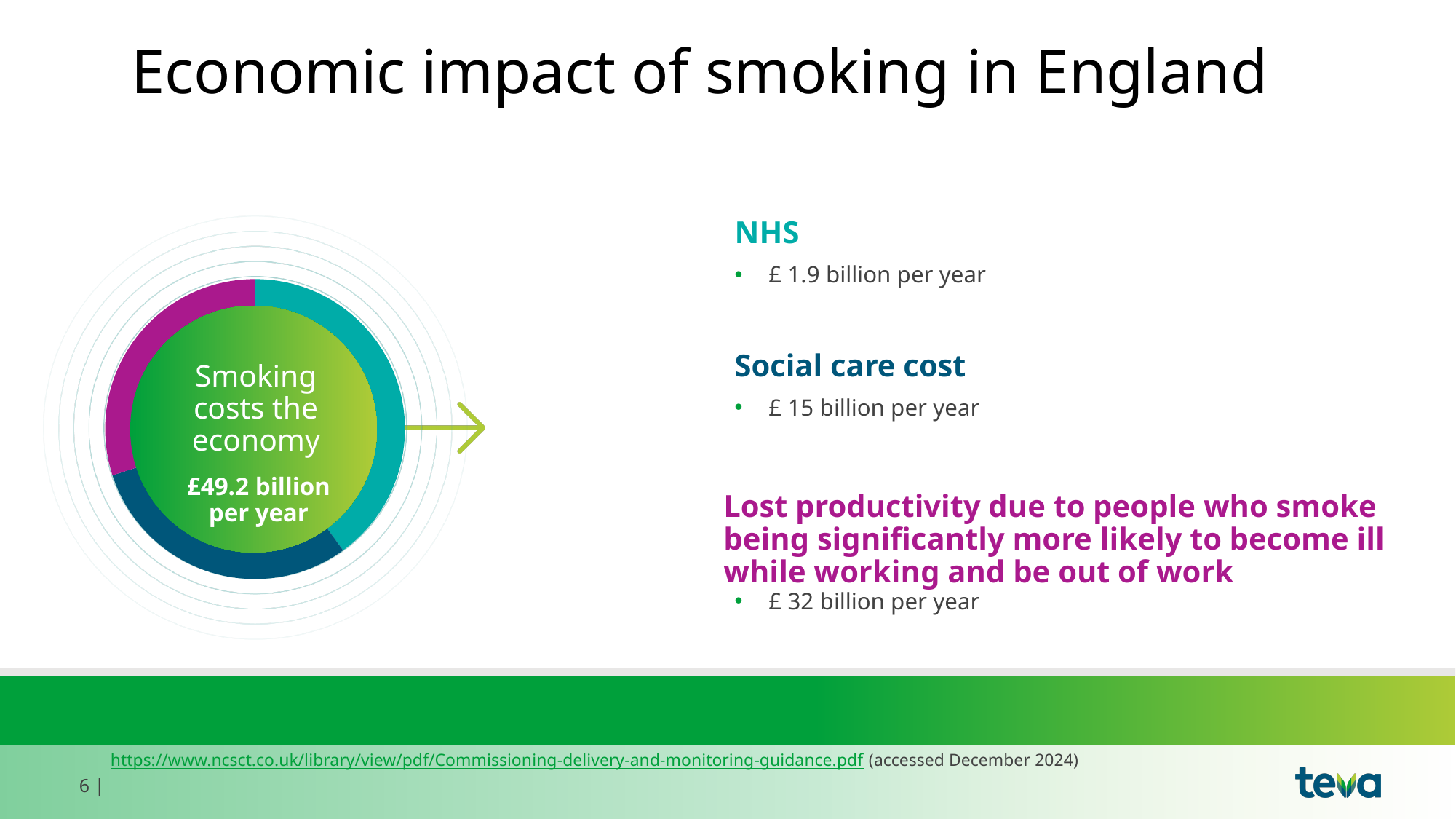
How many segments does the donut chart have? 3 How much larger is the lost productivity cost than the social care cost? £17 billion per year Which cost category has the lowest value? NHS What is the cost of lost productivity due to smoking per year? £ 32 billion per year Which cost category has the highest value? Lost productivity What is the NHS cost of smoking per year? £ 1.9 billion per year According to the slide, what is the total cost of smoking to the economy per year? £49.2 billion per year What kind of chart is shown on the slide? pie (donut) chart What is the social care cost of smoking per year? £ 15 billion per year What is the title of the slide? Economic impact of smoking in England Which is larger, the social care cost or the NHS cost? Social care cost What is the difference between the social care cost and the NHS cost? £13.1 billion per year